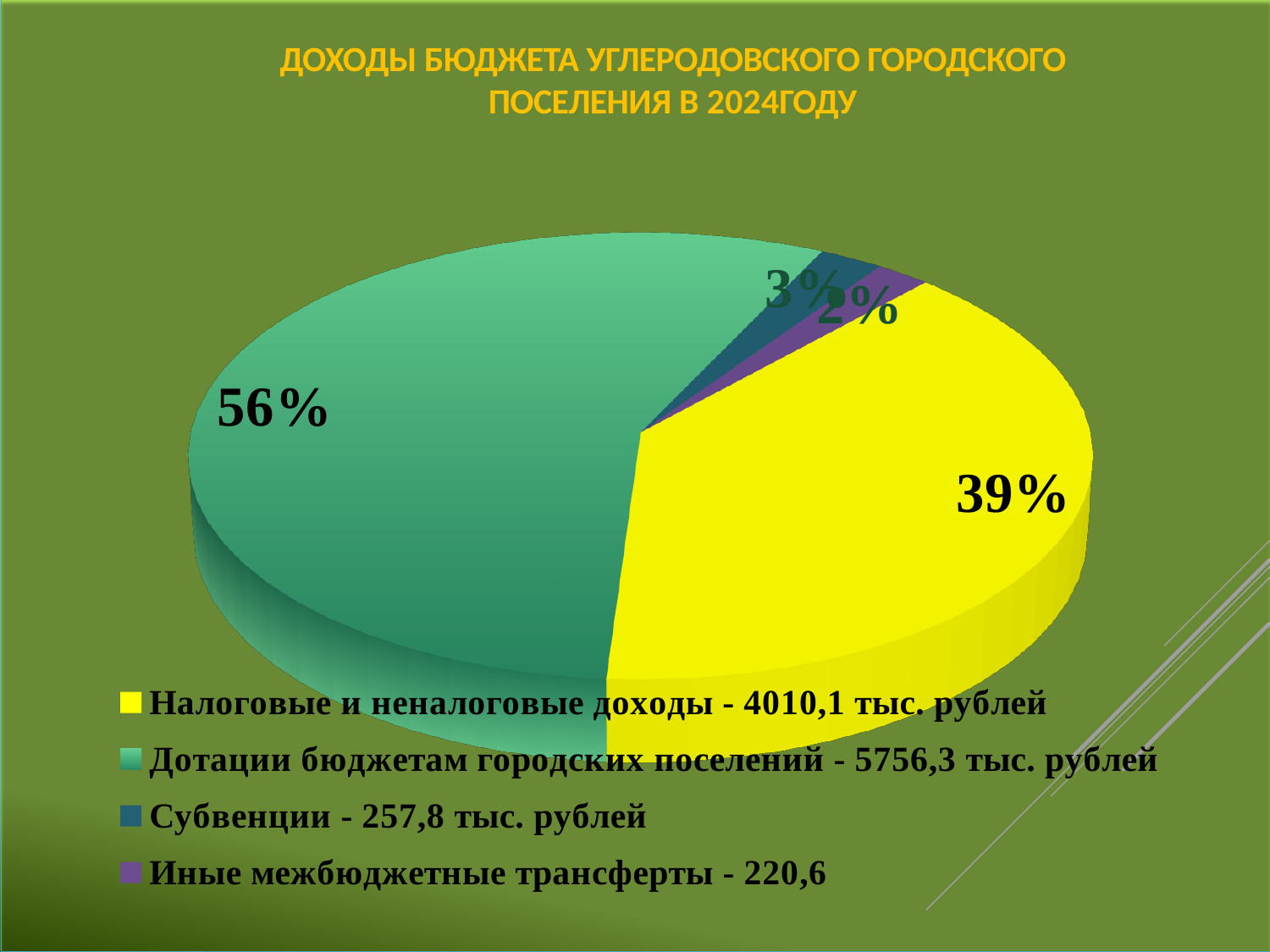
What colour is the slice for Налоговые и неналоговые доходы? Yellow What kind of chart is shown on the slide? Pie chart What share of the pie is Дотации бюджетам городских поселений? 56% What amount is given in the legend for Субвенции? 257,8 тыс. рублей What share of the pie is Налоговые и неналоговые доходы? 39% By how many percentage points does the share of Дотации бюджетам городских поселений exceed the share of Налоговые и неналоговые доходы? 17 percentage points What amount is given in the legend for Дотации бюджетам городских поселений? 5756,3 тыс. рублей Which is larger: Налоговые и неналоговые доходы or Дотации бюджетам городских поселений? Дотации бюджетам городских поселений Which category has the largest share of the pie? Дотации бюджетам городских поселений What amount is given in the legend for Иные межбюджетные трансферты? 220,6 Which category has the smallest share of the pie? Иные межбюджетные трансферты How many slices does the pie chart have? 4